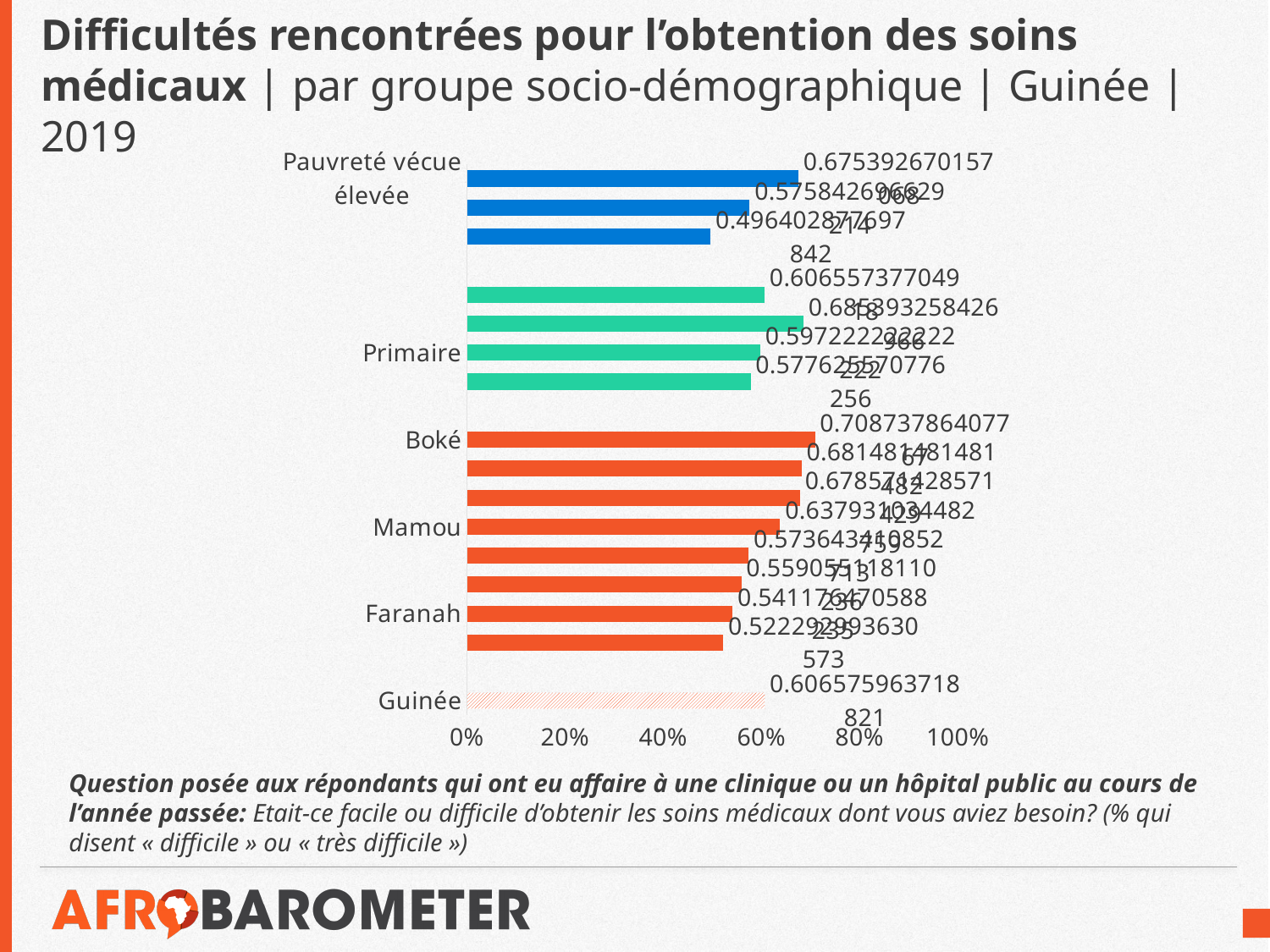
Which is larger, the value for Boké or the value for Guinée? Boké What is the highest value shown on the x axis? 100% Is the value for Guinée greater or less than 40%? greater What kind of chart is shown on the slide? bar chart Among the labeled categories, which has the highest value? Boké Is the value for Guinée greater or less than 80%? less Is the value for Pauvreté vécue élevée greater or less than 80%? less How many bars are plotted in the chart? 16 Which is larger, the value for Boké or the value for Faranah? Boké